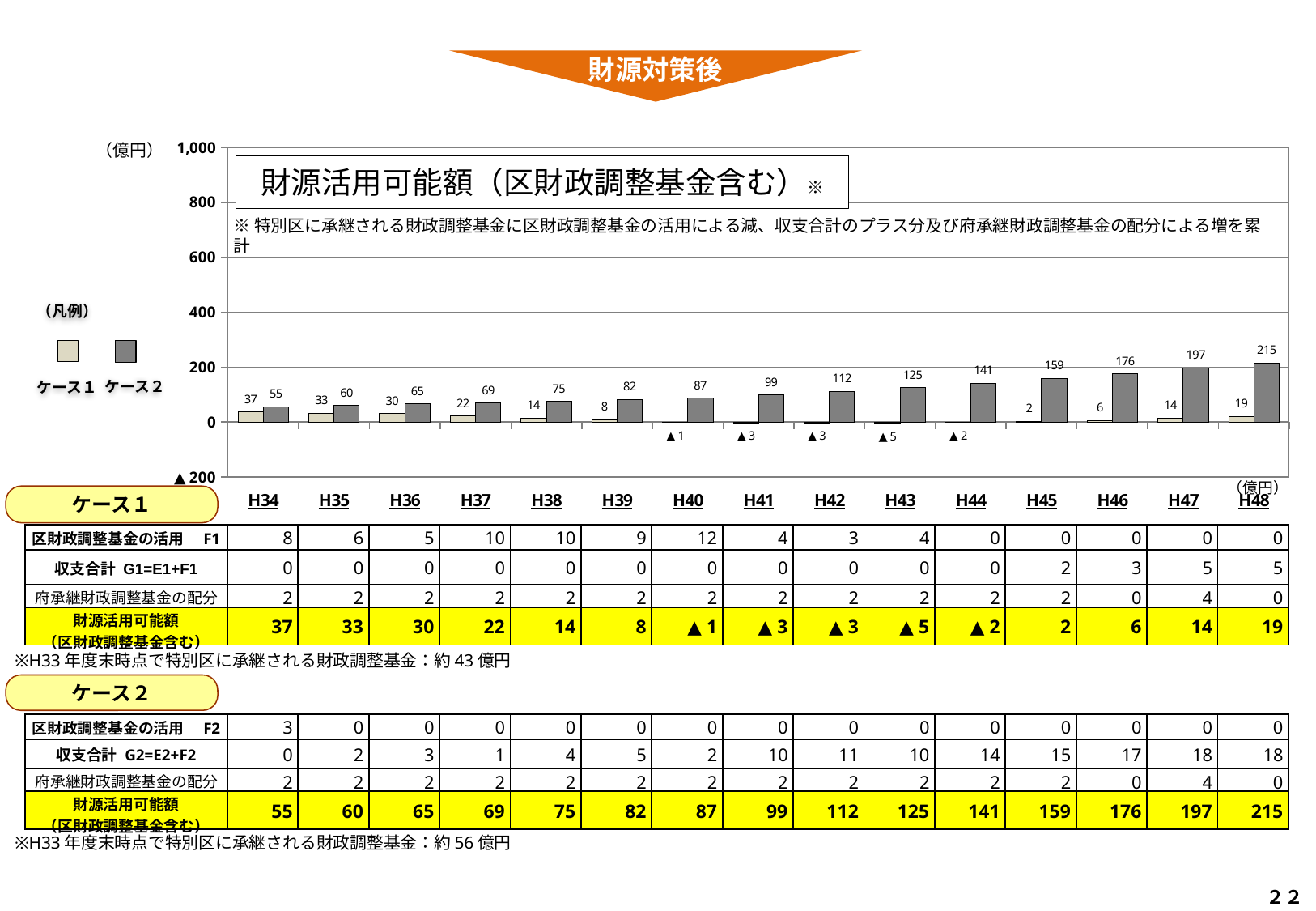
In which year is the value for ケース2 highest? H48 What is the value for ケース1 in H43? ▲5 What is the value for ケース2 in H48? 215 Which is larger in H39, ケース1 or ケース2? ケース2 Do the values for ケース2 rise or fall from H34 to H48? rise In which year is the value for ケース1 lowest? H43 What is the difference between ケース2 and ケース1 in H48? 196 How many series does the legend list for the chart? 2 How many year categories are plotted along the x axis of the chart? 15 What is the title of the chart? 財源活用可能額（区財政調整基金含む） What is the value for ケース1 in H34? 37 What type of chart is shown on the slide? bar chart